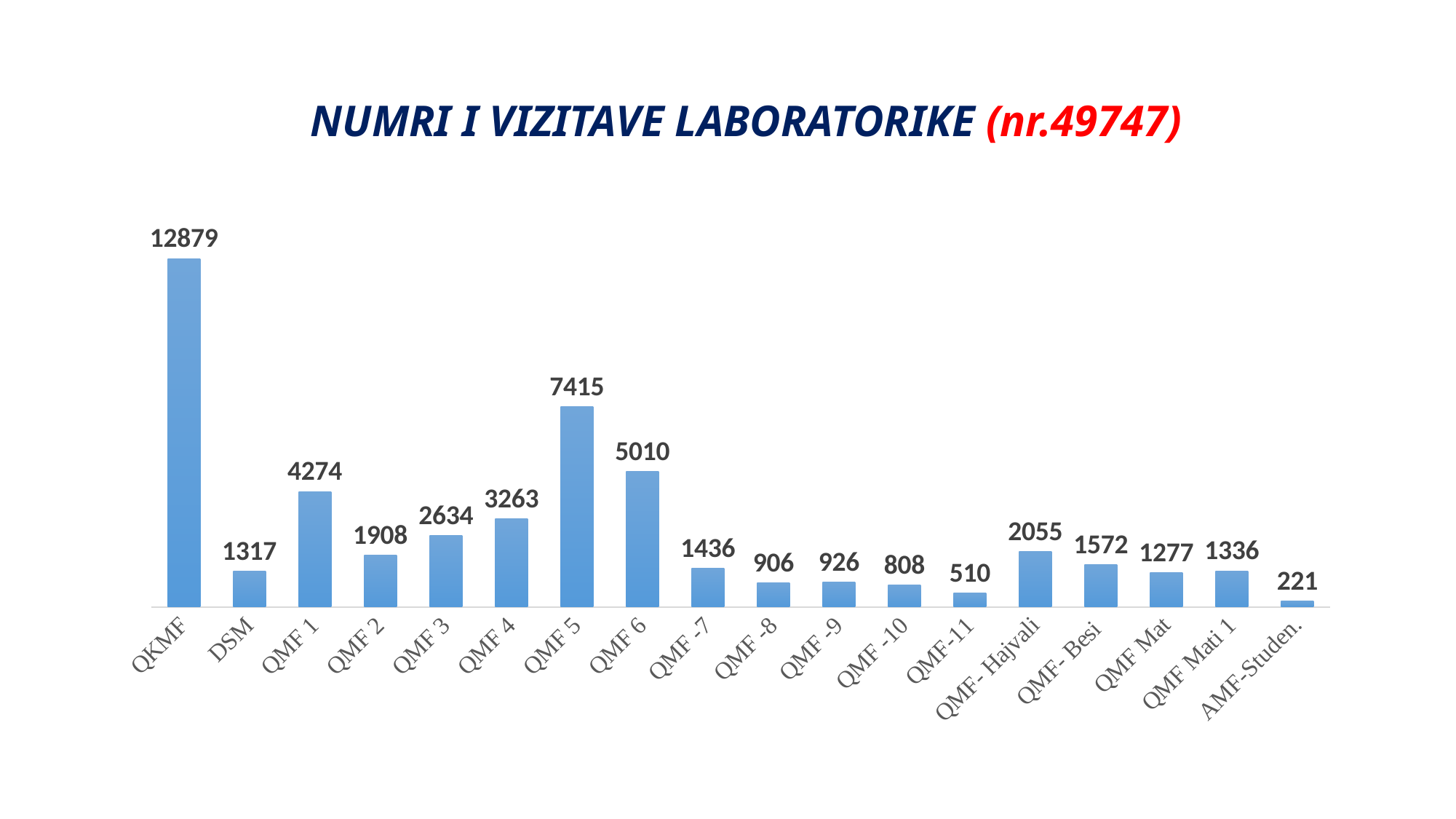
What total number is given in parentheses in the chart title? 49747 Which is larger, the value for QMF 4 or the value for QMF 3? QMF 4 What is the value for DSM? 1317 Which category has the highest value? QKMF What kind of chart is shown on the slide? Bar chart Which is larger, the value for QMF- Besi or the value for QMF Mat? QMF- Besi What is the difference between the values for QMF 6 and QMF 1? 736 What is the difference between the values for QKMF and QMF 5? 5464 How many categories are shown on the x axis? 18 What is the value for QMF- Hajvali? 2055 What is the value for QMF 5? 7415 Which category has the lowest value? AMF-Studen.